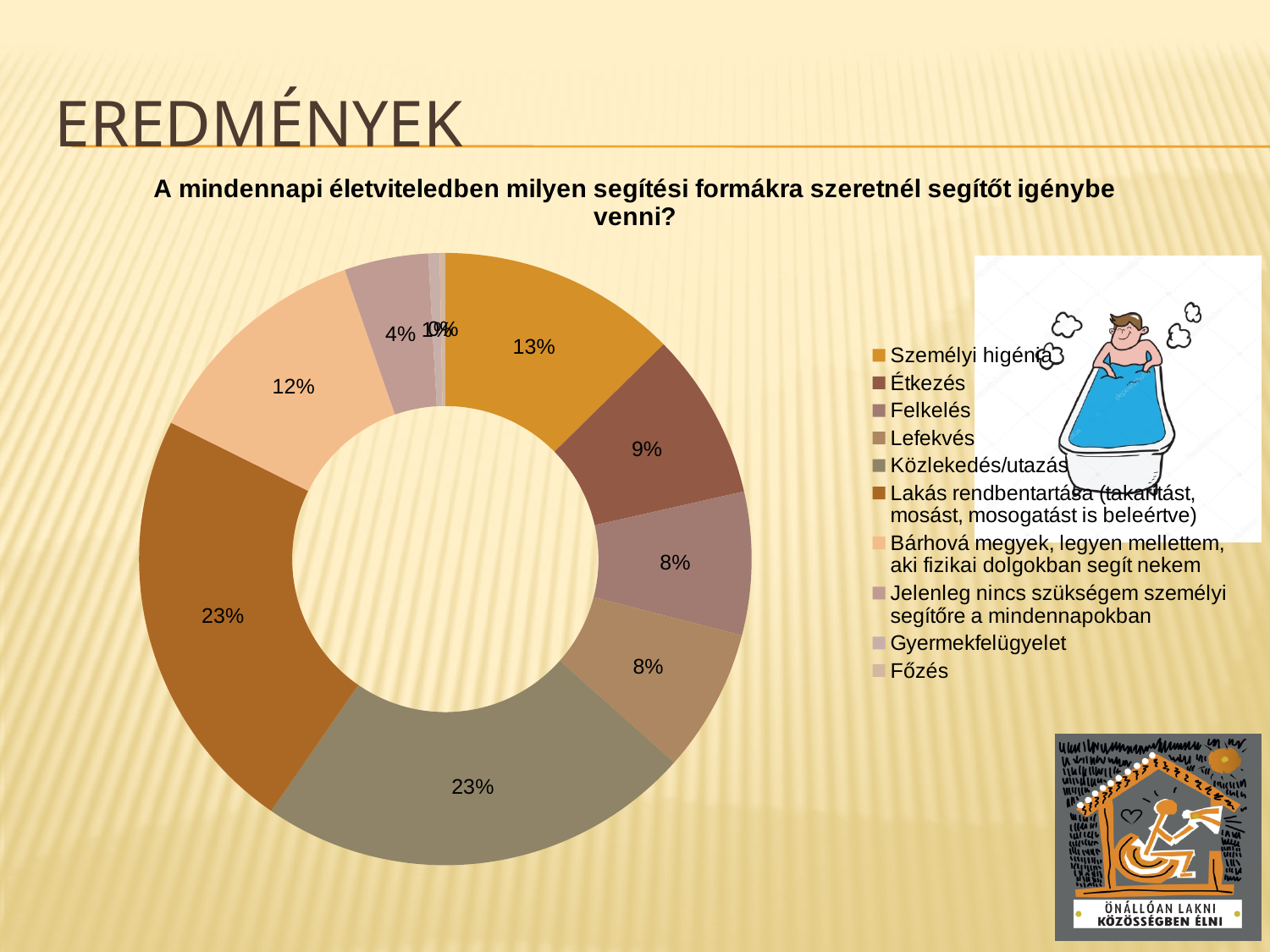
What percentage is shown for Közlekedés/utazás? 23% What percentage is shown for Lakás rendbentartása (takarítást, mosást, mosogatást is beleértve)? 23% What percentage is shown for Étkezés? 9% What is the title of the chart? A mindennapi életviteledben milyen segítési formákra szeretnél segítőt igénybe venni? Which has the larger share, Bárhová megyek, legyen mellettem, aki fizikai dolgokban segít nekem or Jelenleg nincs szükségem személyi segítőre a mindennapokban? Bárhová megyek, legyen mellettem, aki fizikai dolgokban segít nekem How many categories does the legend list? 10 What percentage is shown for Bárhová megyek, legyen mellettem, aki fizikai dolgokban segít nekem? 12% What kind of chart is shown on the slide? Pie (doughnut) chart What percentage is shown for Jelenleg nincs szükségem személyi segítőre a mindennapokban? 4% What percentage is shown for Személyi higénia? 13% What is the difference in percentage points between Közlekedés/utazás and Bárhová megyek, legyen mellettem, aki fizikai dolgokban segít nekem? 11 percentage points Which has the larger share, Személyi higénia or Étkezés? Személyi higénia